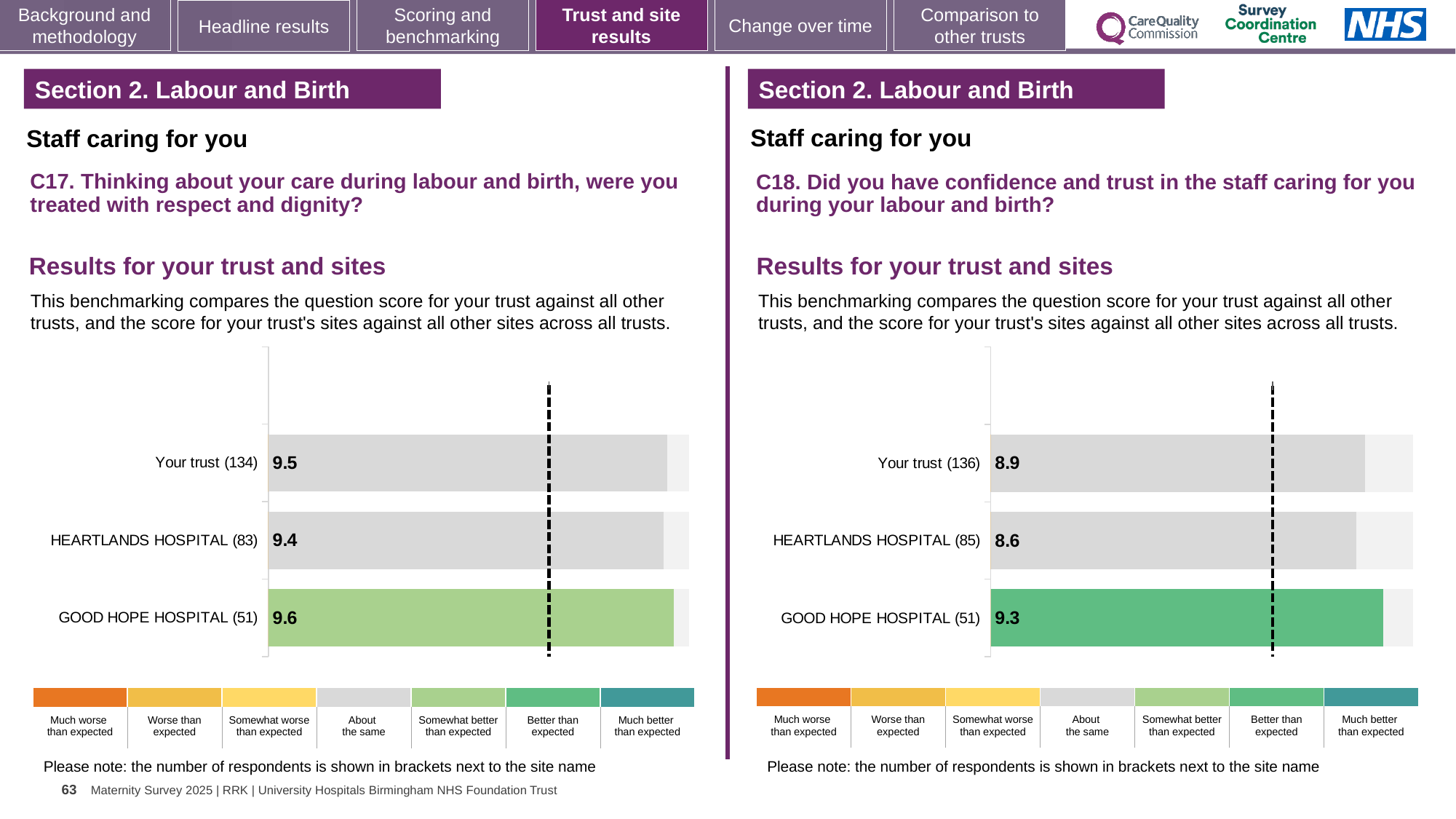
In the C18 chart on the right, which site or trust has the lowest score? HEARTLANDS HOSPITAL In the C18 chart on the right, which has the larger score, Your trust or HEARTLANDS HOSPITAL? Your trust In the C17 chart on the left, how many bars are plotted? 3 In the C17 chart on the left, which site or trust has the highest score? GOOD HOPE HOSPITAL In the C17 chart on the left, what is the score for HEARTLANDS HOSPITAL? 9.4 In the C18 chart on the right, how many respondents are shown in brackets for HEARTLANDS HOSPITAL? 85 In the C18 chart on the right, what is the score for GOOD HOPE HOSPITAL? 9.3 In the C17 chart on the left, what is the difference between the scores for GOOD HOPE HOSPITAL and HEARTLANDS HOSPITAL? 0.2 In the C17 chart on the left, what is the score for Your trust? 9.5 In the C18 chart on the right, what is the difference between the scores for GOOD HOPE HOSPITAL and Your trust? 0.4 What kind of chart is used in the C17 chart on the left? Bar chart In the C18 chart on the right, what is the score for Your trust? 8.9